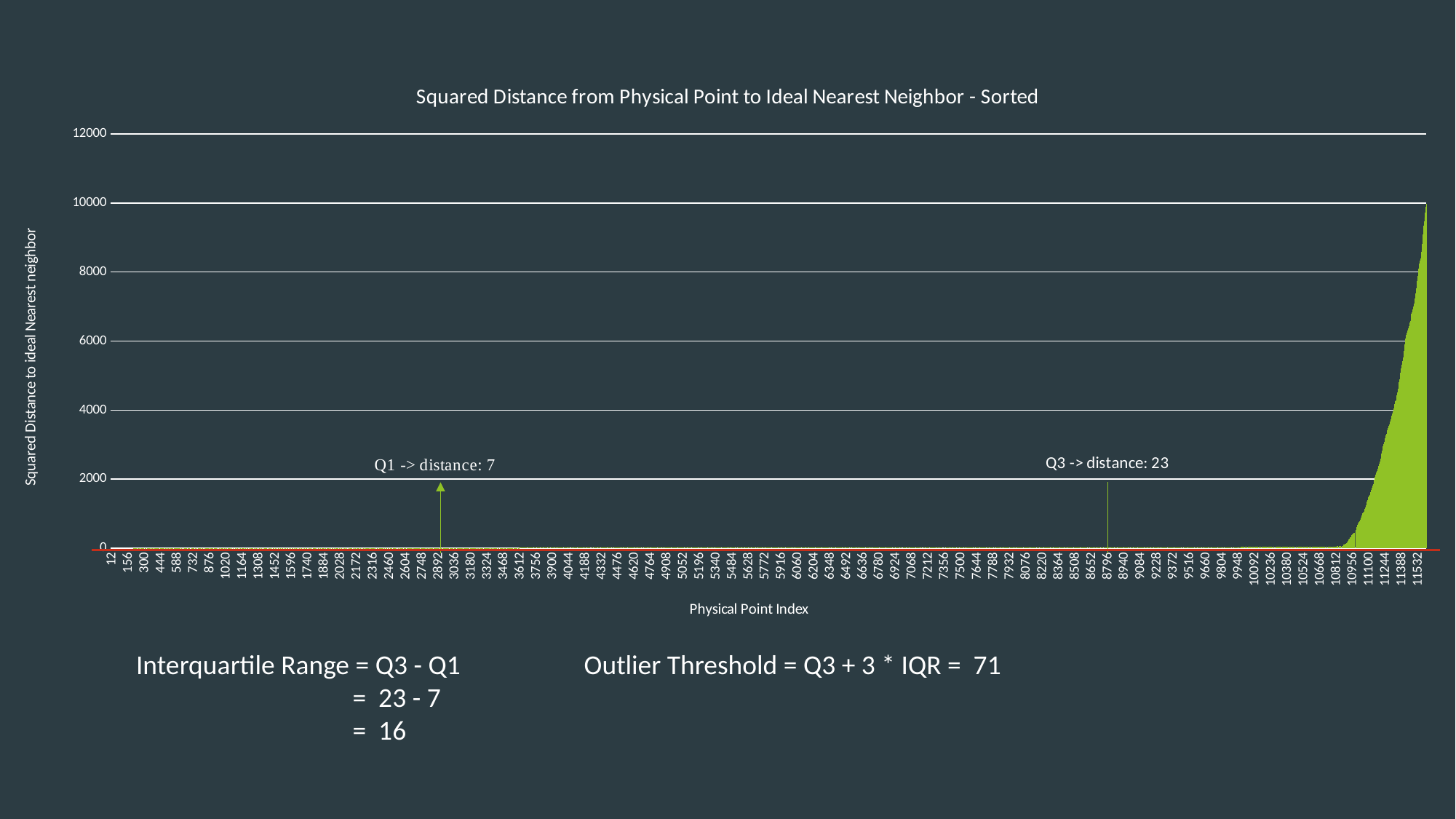
Is the value at Physical Point Index 5052 greater or less than 2000? less What distance value is annotated for Q1 on the chart? 7 What is the difference between the Q3 distance and the Q1 distance? 16 What kind of chart is shown on the slide? area chart Is the highest plotted value on the chart greater or less than 8000? greater What distance value is annotated for Q3 on the chart? 23 What is the title of the chart? Squared Distance from Physical Point to Ideal Nearest Neighbor - Sorted At which end of the x axis does the largest plotted value occur? right end Do the plotted values rise or fall as the Physical Point Index increases along the x axis? rise Is the Q3 distance larger or smaller than the Q1 distance? larger What outlier threshold value is stated below the chart? 71 What is the label of the x axis? Physical Point Index